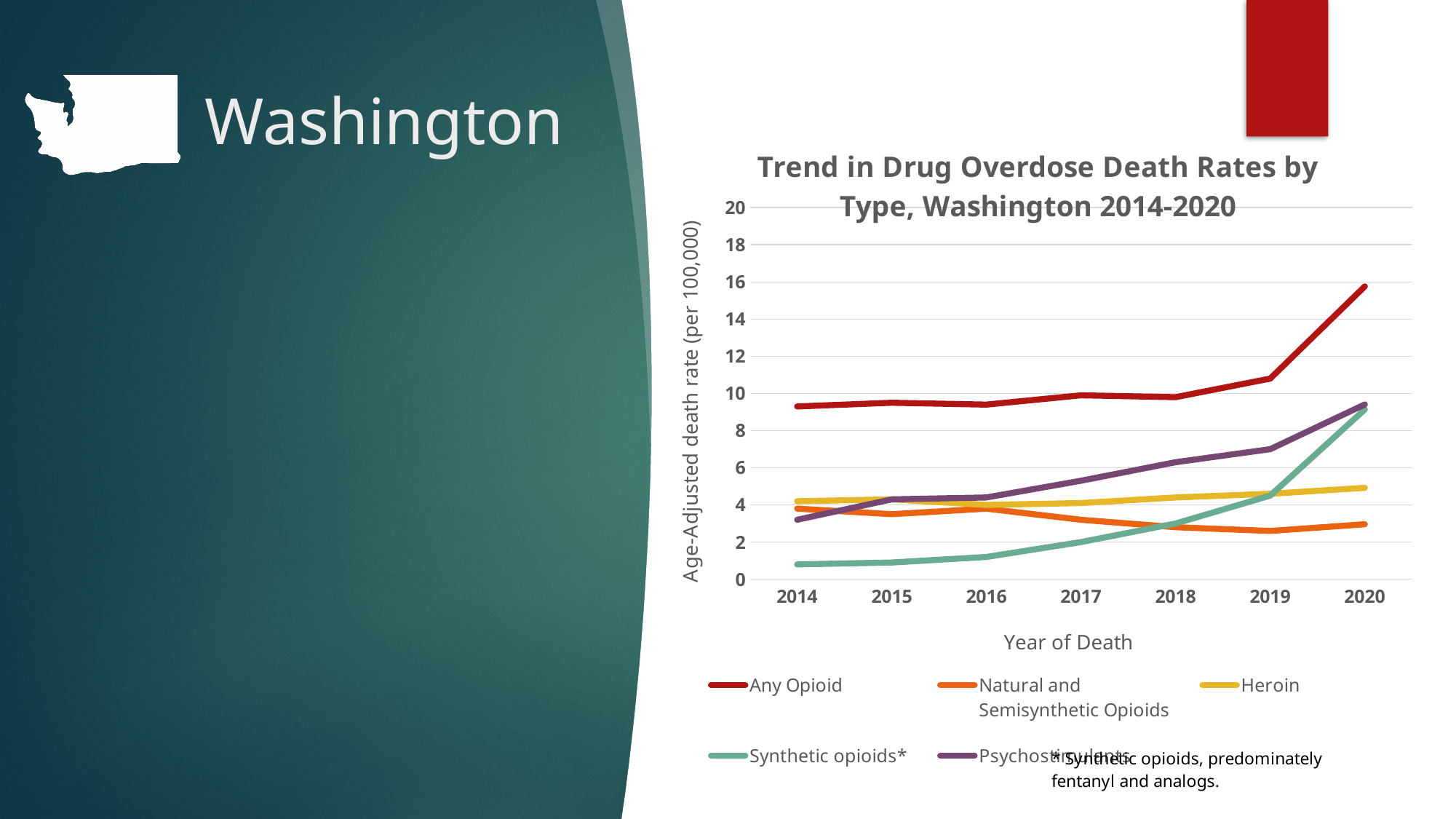
How many series does the legend list? 5 What is the title of the chart? Trend in Drug Overdose Death Rates by Type, Washington 2014-2020 In 2020, which is larger: the Heroin death rate or the Natural and Semisynthetic Opioids death rate? Heroin Is the Any Opioid death rate in 2020 greater or less than 14? greater How many years are plotted along the x axis? 7 Does the Synthetic opioids* death rate rise or fall from 2014 to 2020? Rise Is the Synthetic opioids* death rate in 2014 greater or less than 2? less Which series has the highest death rate in 2020? Any Opioid Which series has the lowest death rate in 2014? Synthetic opioids* What kind of chart is shown on the slide? Line chart Is the Heroin death rate in 2020 greater or less than 6? less What is the label of the y axis? Age-Adjusted death rate (per 100,000)